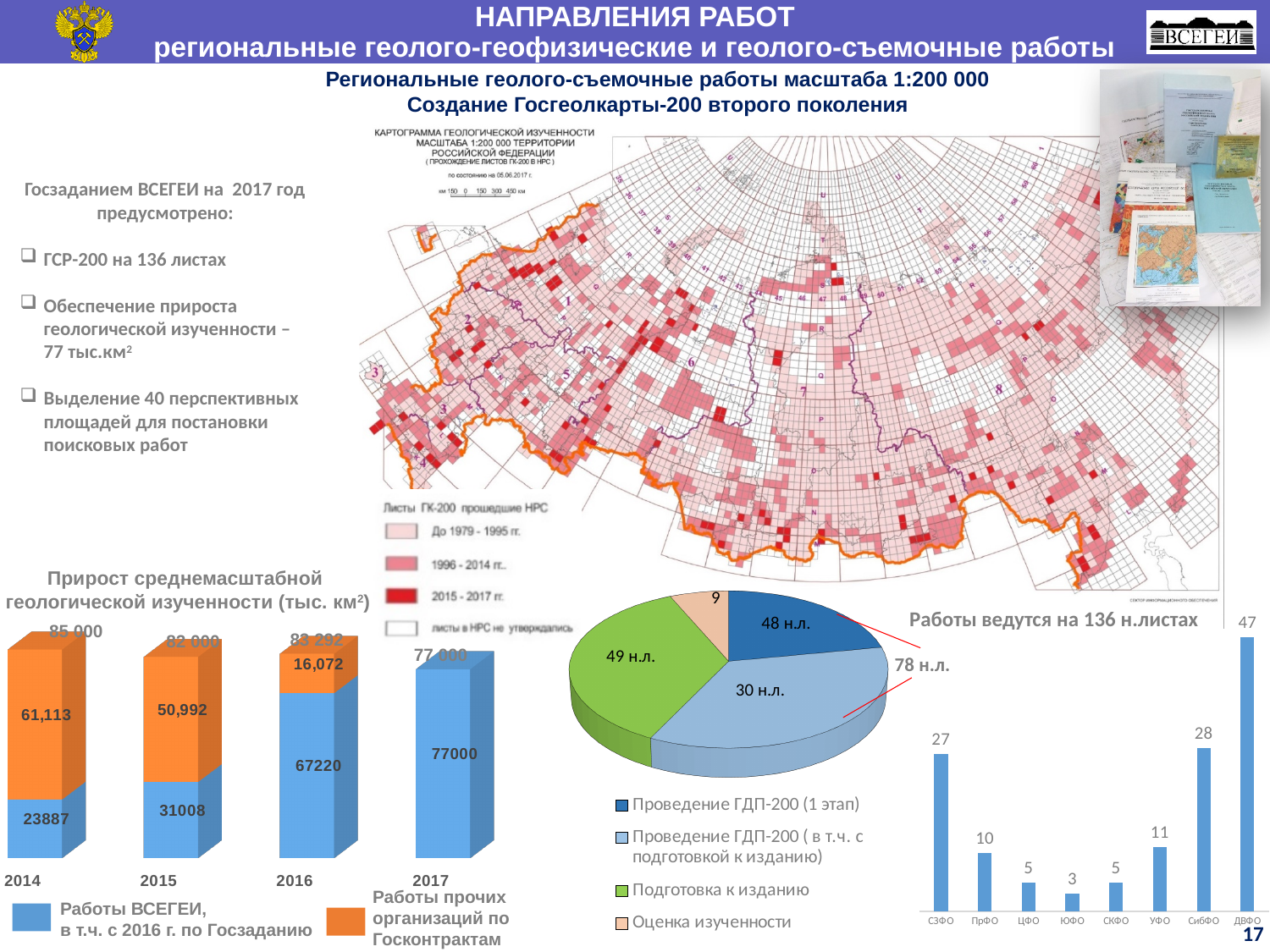
In the bar chart at the bottom right (Работы ведутся на 136 н.листах), what is the value for ДВФО? 47 In the stacked bar chart at the bottom left (Прирост среднемасштабной геологической изученности), what is the value for Работы ВСЕГЕИ in 2015? 31008 In the bar chart at the bottom right (Работы ведутся на 136 н.листах), how many federal districts are shown? 8 What kind of chart is the chart at the bottom left (Прирост среднемасштабной геологической изученности)? Stacked bar chart In the bar chart at the bottom right (Работы ведутся на 136 н.листах), which is larger, the value for УФО or the value for ПрФО? УФО In the bar chart at the bottom right (Работы ведутся на 136 н.листах), what is the difference between the values for СибФО and СЗФО? 1 In the stacked bar chart at the bottom left (Прирост среднемасштабной геологической изученности), what is the total for 2016? 83 292 In the bar chart at the bottom right (Работы ведутся на 136 н.листах), which federal district has the lowest value? ЮФО In the pie chart at the bottom centre, which slice is the smallest? Оценка изученности In the pie chart at the bottom centre, what is the value of the slice for Подготовка к изданию? 49 н.л. In the pie chart at the bottom centre, how many entries does the legend list? 4 In the bar chart at the bottom right (Работы ведутся на 136 н.листах), which federal district has the highest value? ДВФО